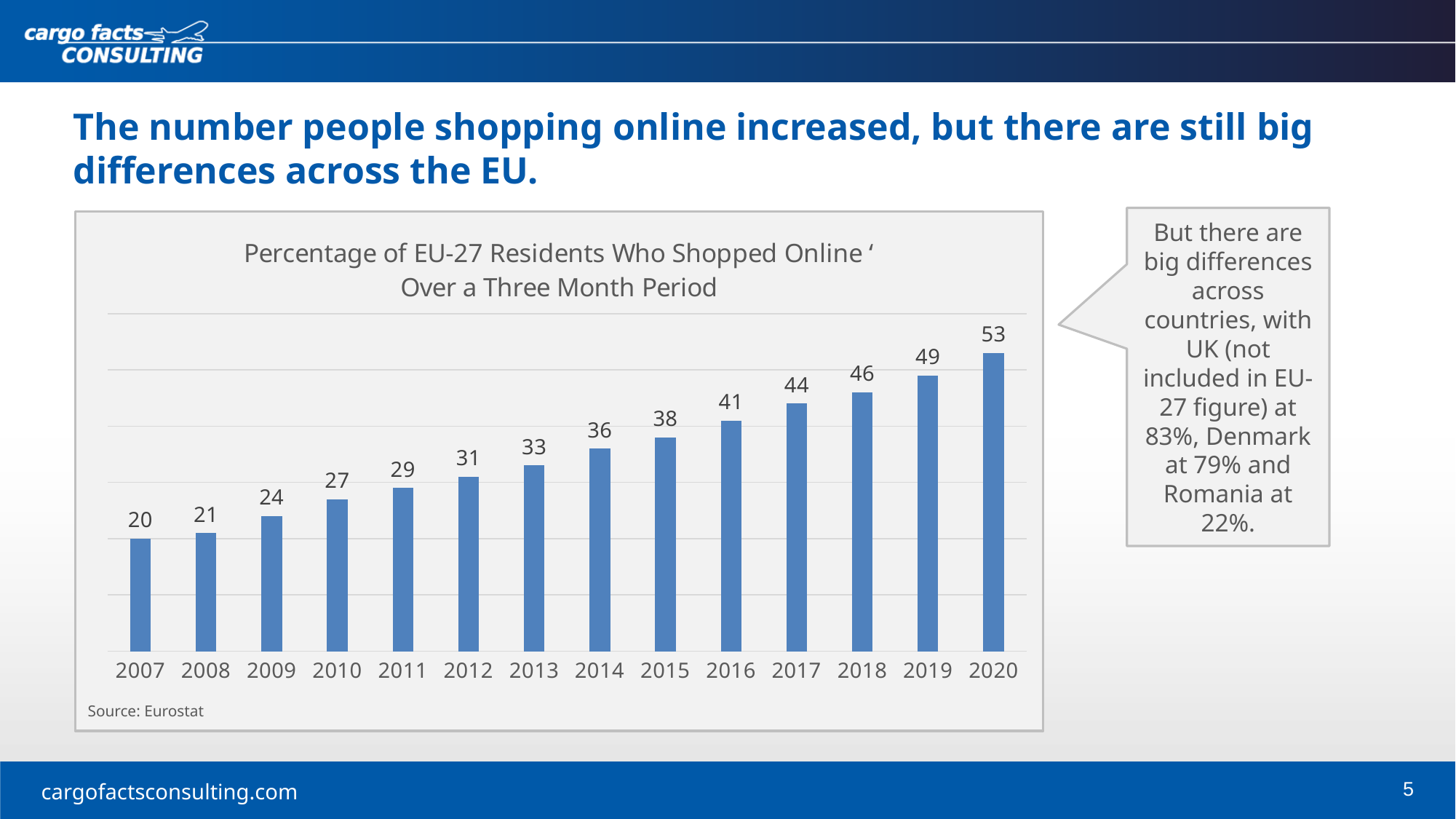
What is the difference between the values for 2018 and 2017? 2 Which year has the lowest percentage of EU-27 residents who shopped online? 2007 What kind of chart is shown on the slide? Bar chart How many years are shown on the x axis of the chart? 14 What is the value shown for 2007? 20 What percentage of EU-27 residents shopped online over a three month period in 2014? 36 What is the difference between the values for 2020 and 2007? 33 What is the source cited for the chart? Eurostat Which year has the highest percentage of EU-27 residents who shopped online? 2020 Which year has a larger value, 2012 or 2016? 2016 Do the values rise or fall from 2007 to 2020? Rise What is the value shown for 2020? 53